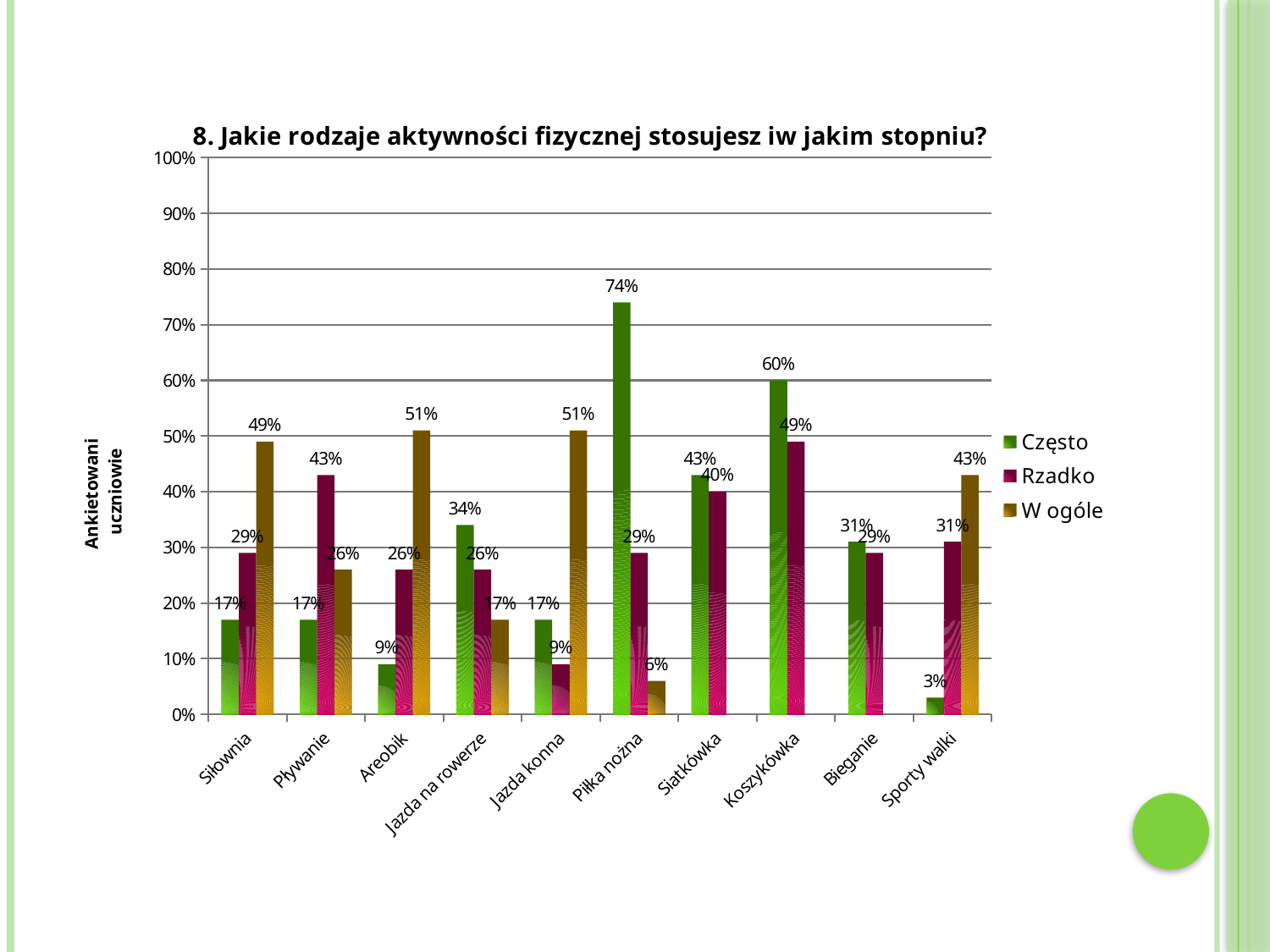
How many categories are shown on the x axis? 10 What is the value of the Rzadko series for Pływanie? 43% Which category has the lowest value in the Często series? Sporty walki What is the value of the Często series for Piłka nożna? 74% How many series does the legend list? 3 What is the value of the Często series for Sporty walki? 3% What kind of chart is shown on the slide? Bar chart Which category has the highest value in the Często series? Piłka nożna What is the difference between the Często and Rzadko values for Piłka nożna? 45 percentage points What are the three series named in the legend? Często, Rzadko, W ogóle Which is larger for Koszykówka: the Często value or the Rzadko value? Często What is the value of the W ogóle series for Siłownia? 49%